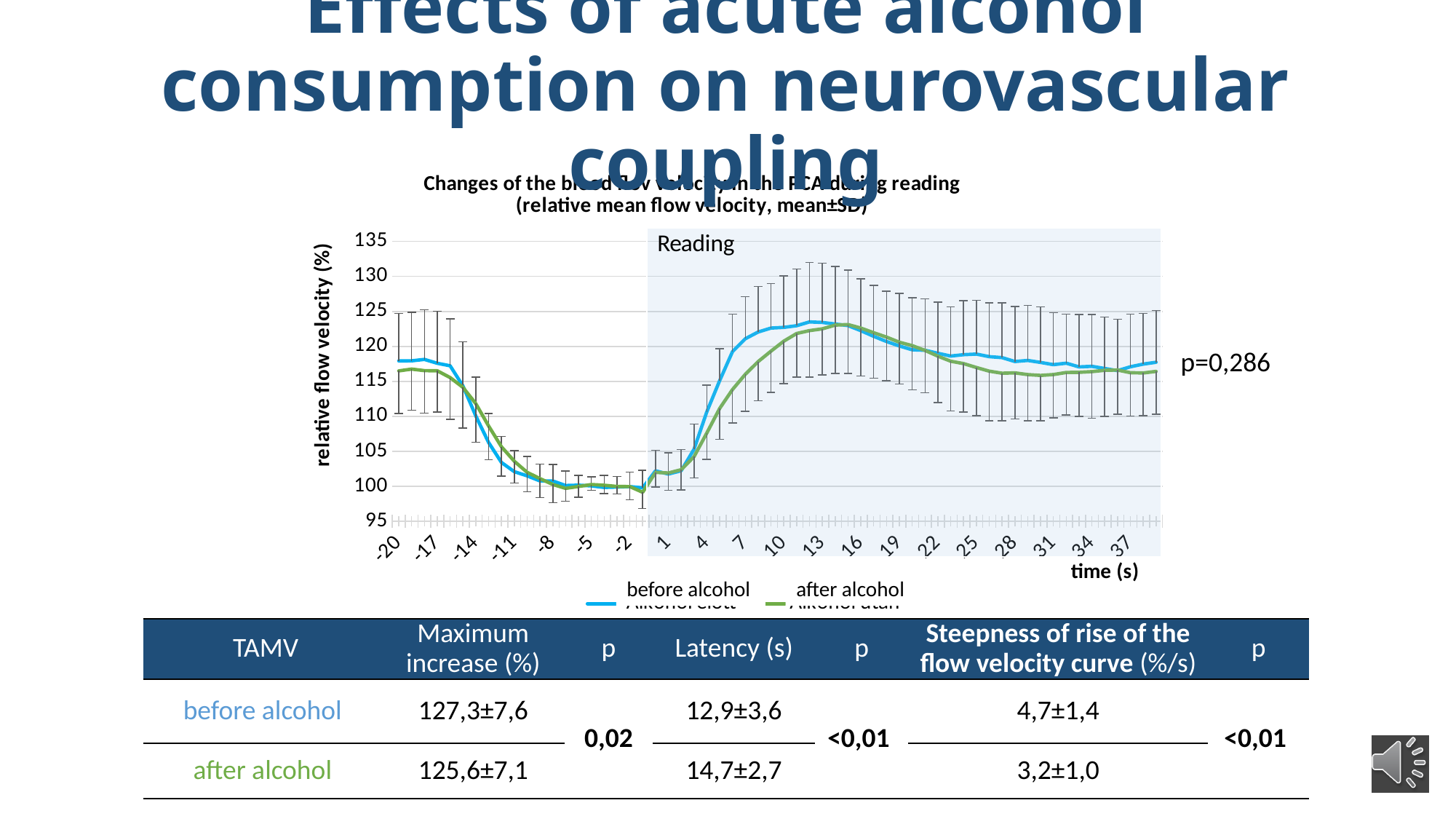
Between time -20 s and -8 s, do the curves rise or fall? fall What kind of chart is shown on the slide? line chart Is the value for 'after alcohol' at time 7 s greater or less than 120? less How many series does the chart legend list? 2 Is the peak value of the 'before alcohol' curve during reading greater or less than 120? greater Between time 1 s and 13 s, does the 'before alcohol' curve rise or fall? rise Is the value for 'after alcohol' at time -8 s greater or less than 105? less At time -20 s, which series has the higher relative flow velocity, 'before alcohol' or 'after alcohol'? before alcohol Which two series are listed in the chart legend? before alcohol, after alcohol What is the label of the vertical axis of the chart? relative flow velocity (%) At time 7 s, which series has the higher relative flow velocity, 'before alcohol' or 'after alcohol'? before alcohol